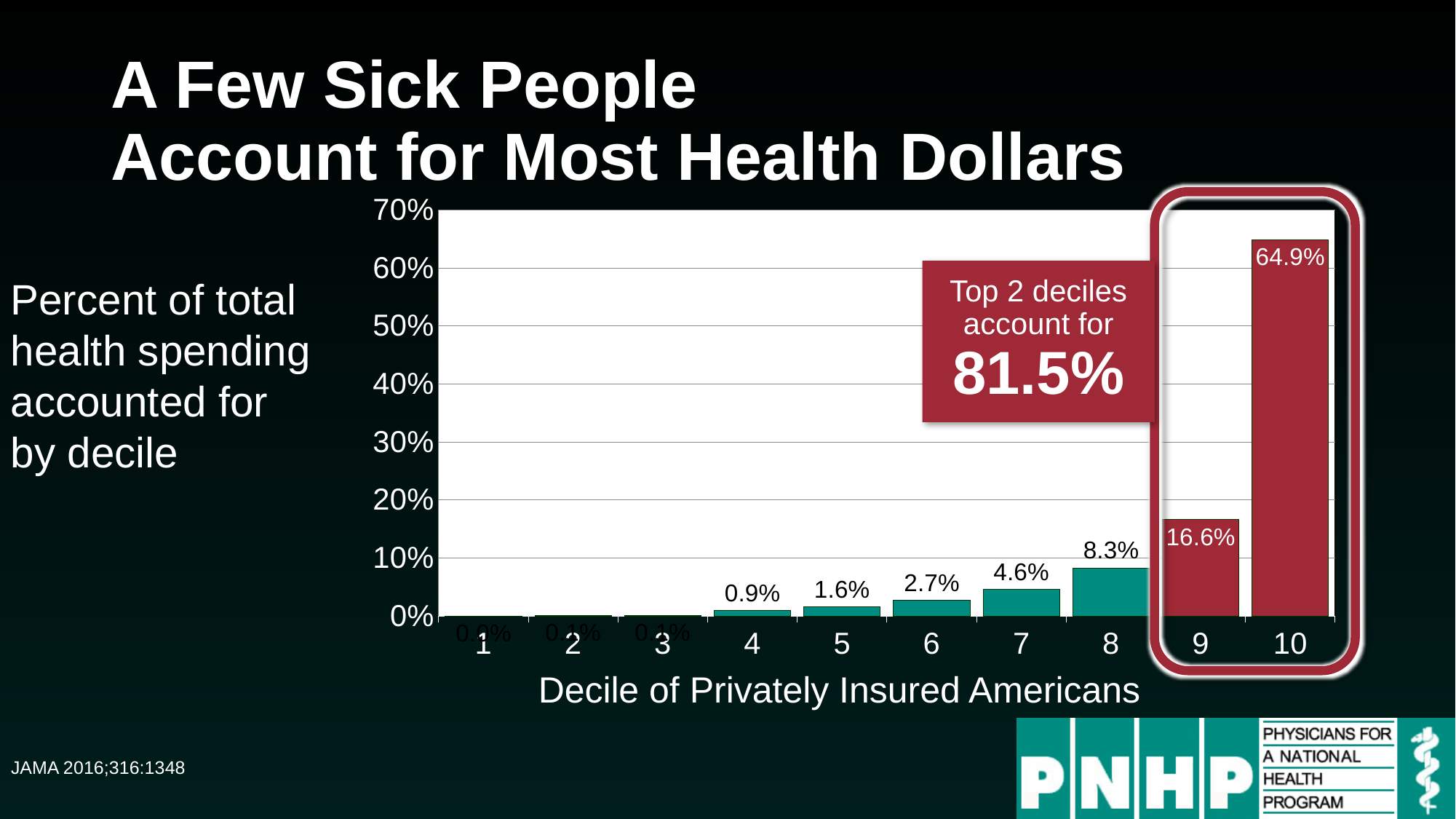
What is the value shown for decile 5? 1.6% What kind of chart is shown on the slide? Bar chart According to the callout on the chart, what share of spending do the top 2 deciles account for? 81.5% Which decile accounts for the highest share of total health spending? 10 How many deciles are shown on the x axis? 10 Which has a larger value, decile 7 or decile 6? Decile 7 Do the values rise or fall as the decile number increases from 1 to 10? Rise What is the difference between the values for decile 10 and decile 9? 48.3% What is the value shown for decile 8? 8.3% Is the value for decile 10 greater or less than 60%? greater What percent of total health spending is accounted for by decile 9? 16.6% What percent of total health spending is accounted for by decile 10? 64.9%